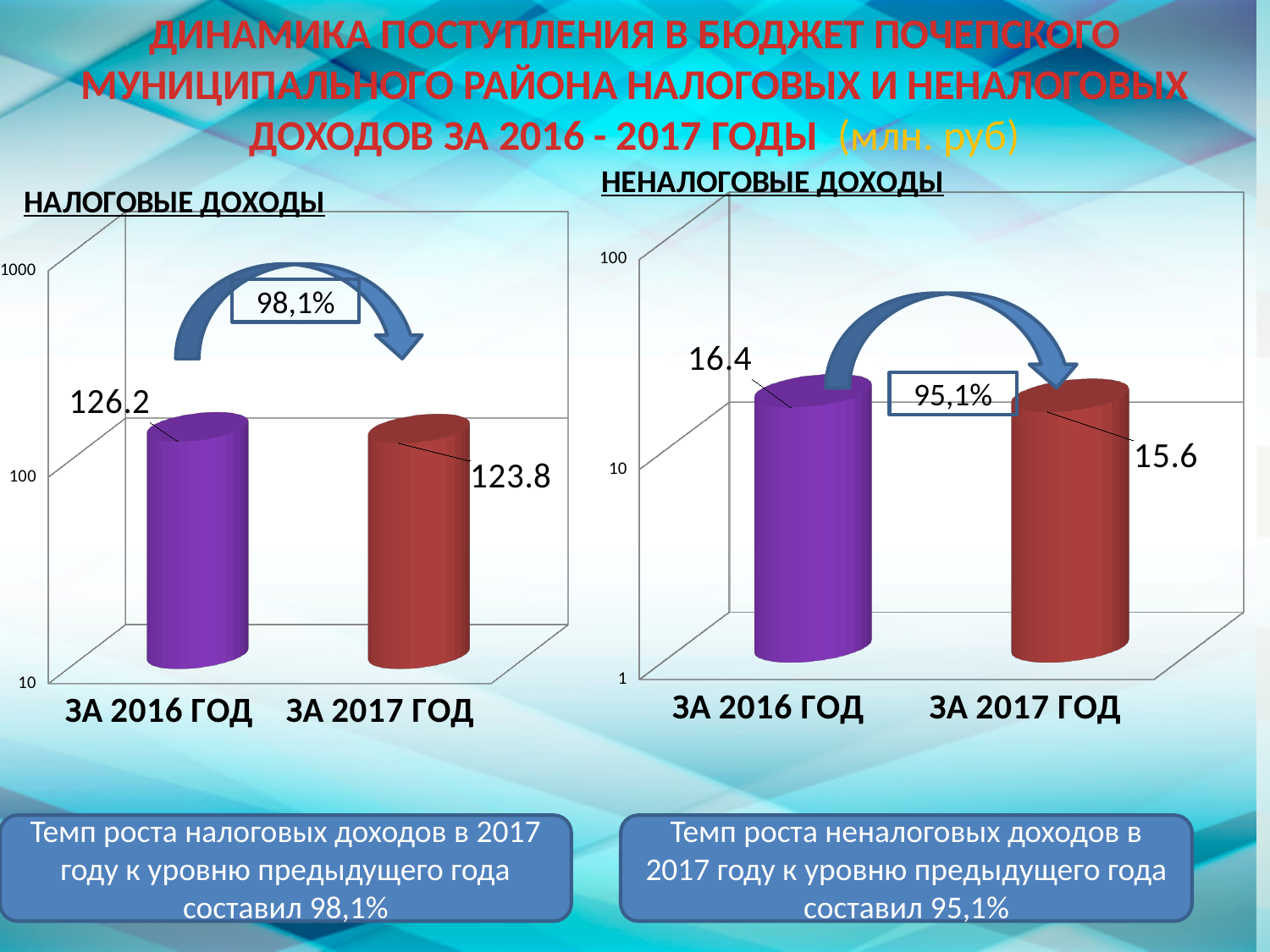
How many categories are shown in the НЕНАЛОГОВЫЕ ДОХОДЫ chart? 2 In the НЕНАЛОГОВЫЕ ДОХОДЫ chart, which year has the lower value? ЗА 2017 ГОД In the НАЛОГОВЫЕ ДОХОДЫ chart, what is the value for ЗА 2017 ГОД? 123.8 In the НЕНАЛОГОВЫЕ ДОХОДЫ chart, what is the value for ЗА 2017 ГОД? 15.6 In the НЕНАЛОГОВЫЕ ДОХОДЫ chart, what is the difference between the 2016 and 2017 values? 0.8 In the НАЛОГОВЫЕ ДОХОДЫ chart, which year has the higher value? ЗА 2016 ГОД In the НАЛОГОВЫЕ ДОХОДЫ chart, what is the difference between the 2016 and 2017 values? 2.4 What kind of chart is the НАЛОГОВЫЕ ДОХОДЫ chart? bar chart In the НЕНАЛОГОВЫЕ ДОХОДЫ chart, what is the value for ЗА 2016 ГОД? 16.4 What growth rate percentage is shown in the arrow label on the НЕНАЛОГОВЫЕ ДОХОДЫ chart? 95,1% In the НАЛОГОВЫЕ ДОХОДЫ chart, do the values rise or fall from 2016 to 2017? fall In the НАЛОГОВЫЕ ДОХОДЫ chart, what is the value for ЗА 2016 ГОД? 126.2